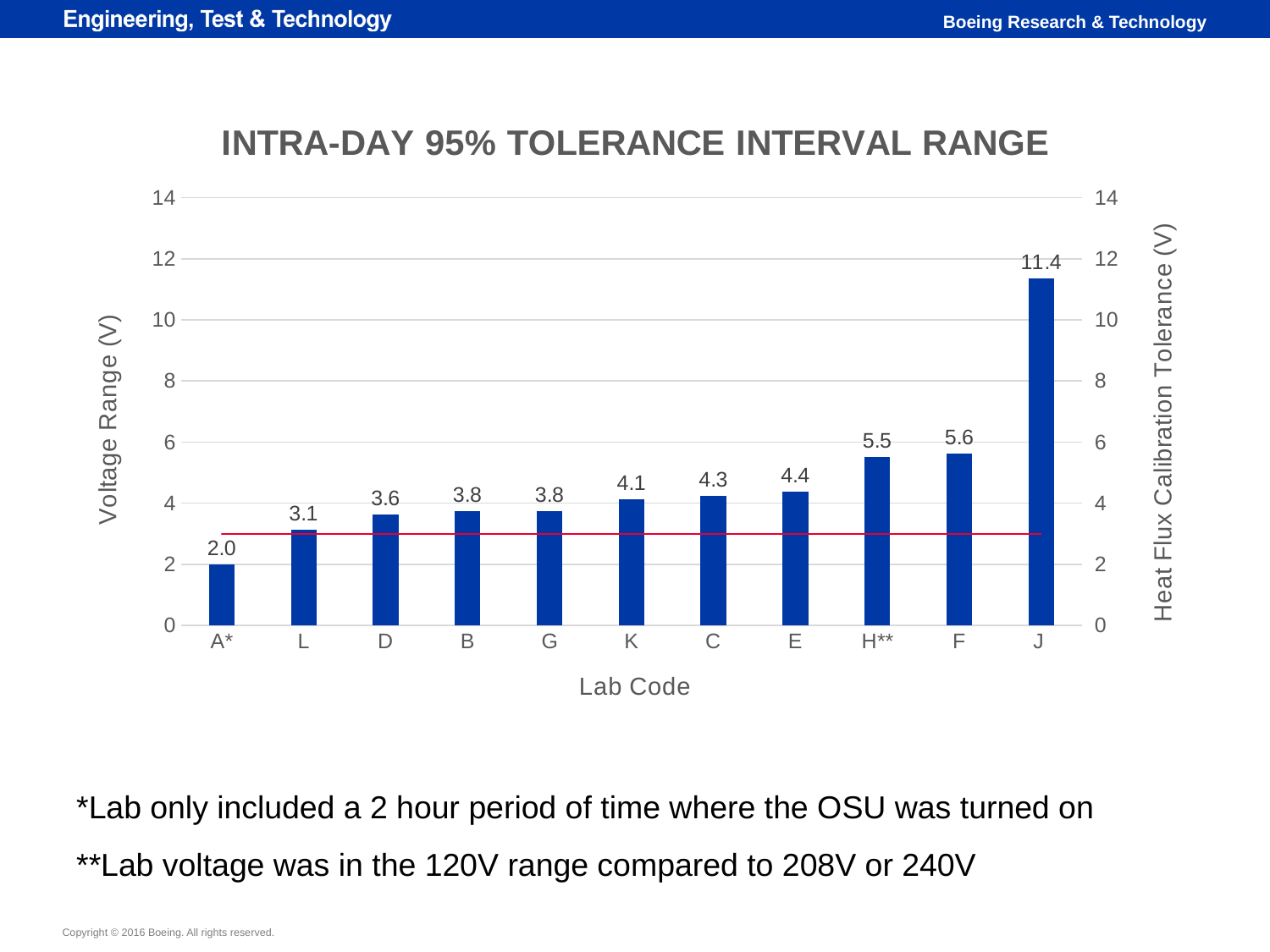
What kind of chart is shown on the slide? Combination bar and line chart Is the voltage range value for lab code E greater or less than 4? greater Which lab code has the lowest voltage range? A* What is the difference between the voltage range values for lab codes J and F? 5.8 What is the voltage range value for lab code H**? 5.5 How many lab codes are shown on the x axis? 11 What is the difference between the voltage range values for lab codes L and A*? 1.1 What is the voltage range value for lab code J? 11.4 What is the voltage range value for lab code A*? 2.0 Which lab code has the highest voltage range? J Which has a larger voltage range, lab code C or lab code D? C What is the title of the chart? INTRA-DAY 95% TOLERANCE INTERVAL RANGE